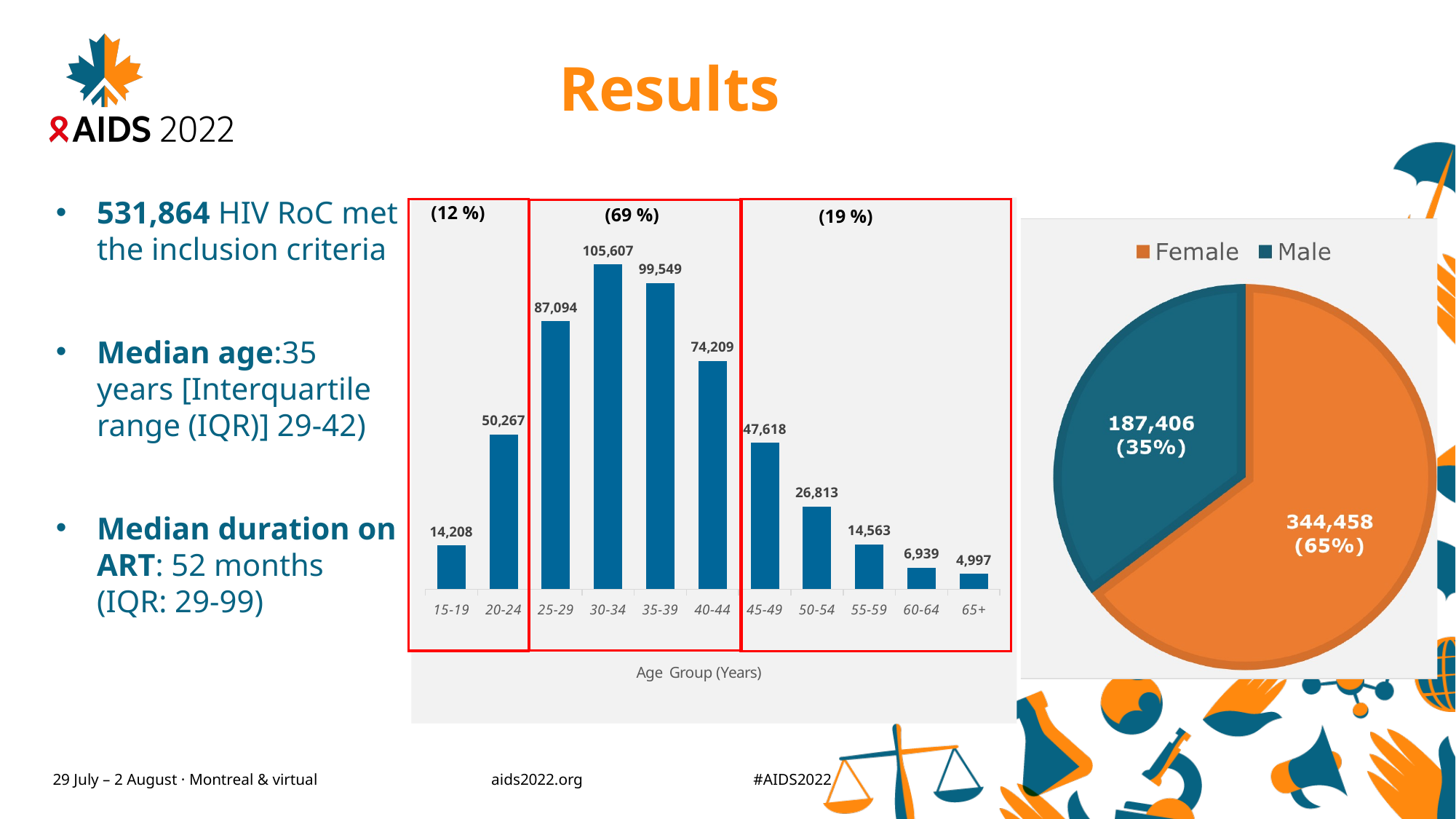
In the pie chart, what is the value shown for Male? 187,406 In the bar chart, which age group has a larger value, 20-24 or 45-49? 20-24 In the pie chart, what share of the total is Female? 65% In the bar chart, what is the value for the 65+ age group? 4,997 How many series does the legend of the pie chart list? 2 How many age groups are shown in the bar chart? 11 In the bar chart, which age group has the highest value? 30-34 What kind of chart is the chart on the right side of the slide? Pie chart In the bar chart, what is the value for the 30-34 age group? 105,607 In the bar chart, what is the difference between the values for the 30-34 and 35-39 age groups? 6,058 In the bar chart, what is the x-axis title? Age Group (Years) In the bar chart, which age group has the lowest value? 65+